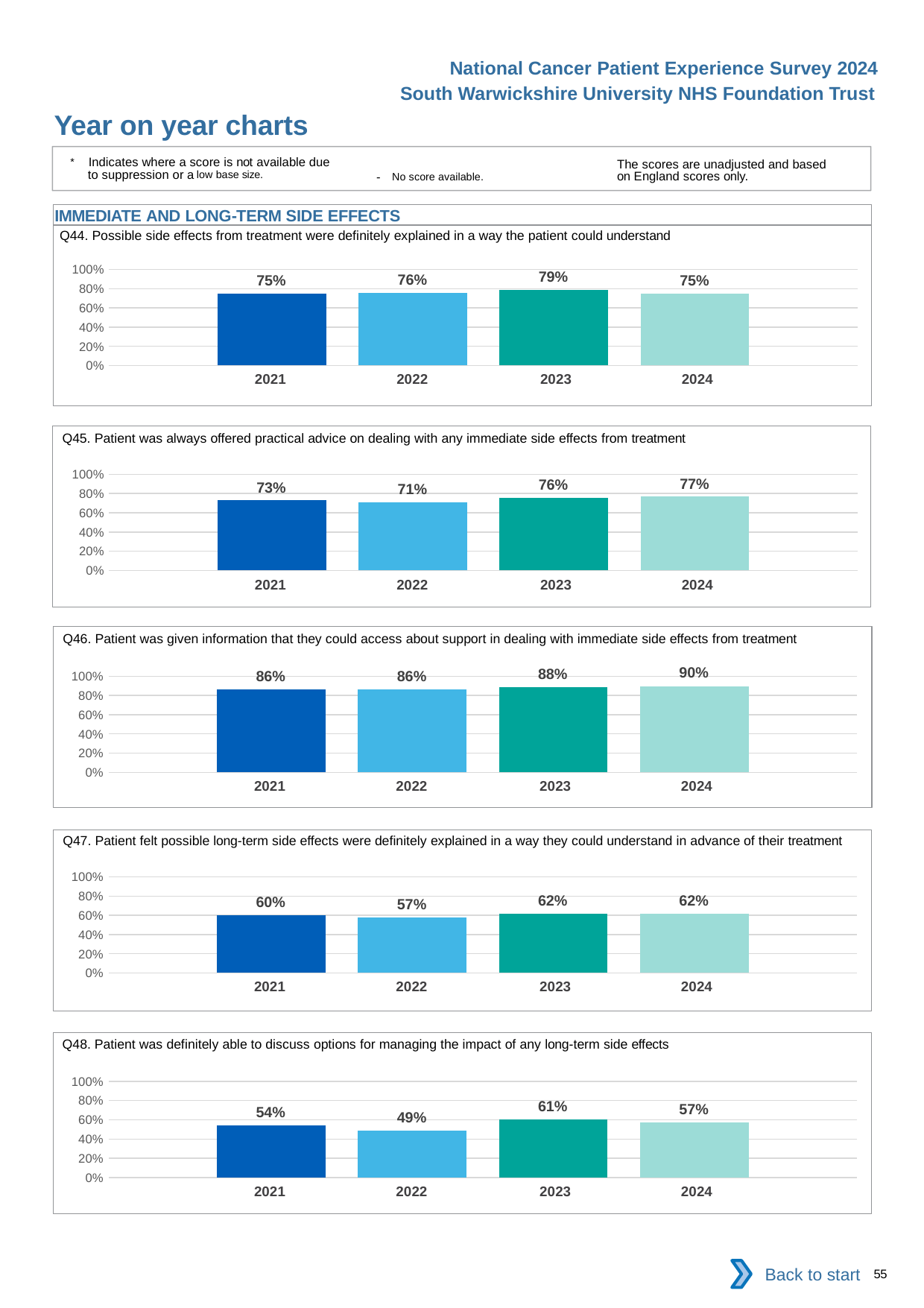
In the Q46 chart, do the values rise or fall from 2022 to 2024? rise In the Q46 chart, what is the difference between the 2024 and 2021 values? 4% In the Q48 chart, which year has the highest value? 2023 What type of chart is the Q45 chart? bar chart In the Q47 chart, what is the value for 2024? 62% In the Q47 chart, which is larger, the value for 2021 or the value for 2022? 2021 In the Q45 chart, what is the difference between the 2024 and 2022 values? 6% How many charts are shown on the slide? 5 In the Q44 chart, what is the value for 2023? 79% In the Q48 chart, what is the value for 2022? 49% How many years are shown on the x axis of the Q44 chart? 4 In the Q45 chart, which year has the lowest value? 2022